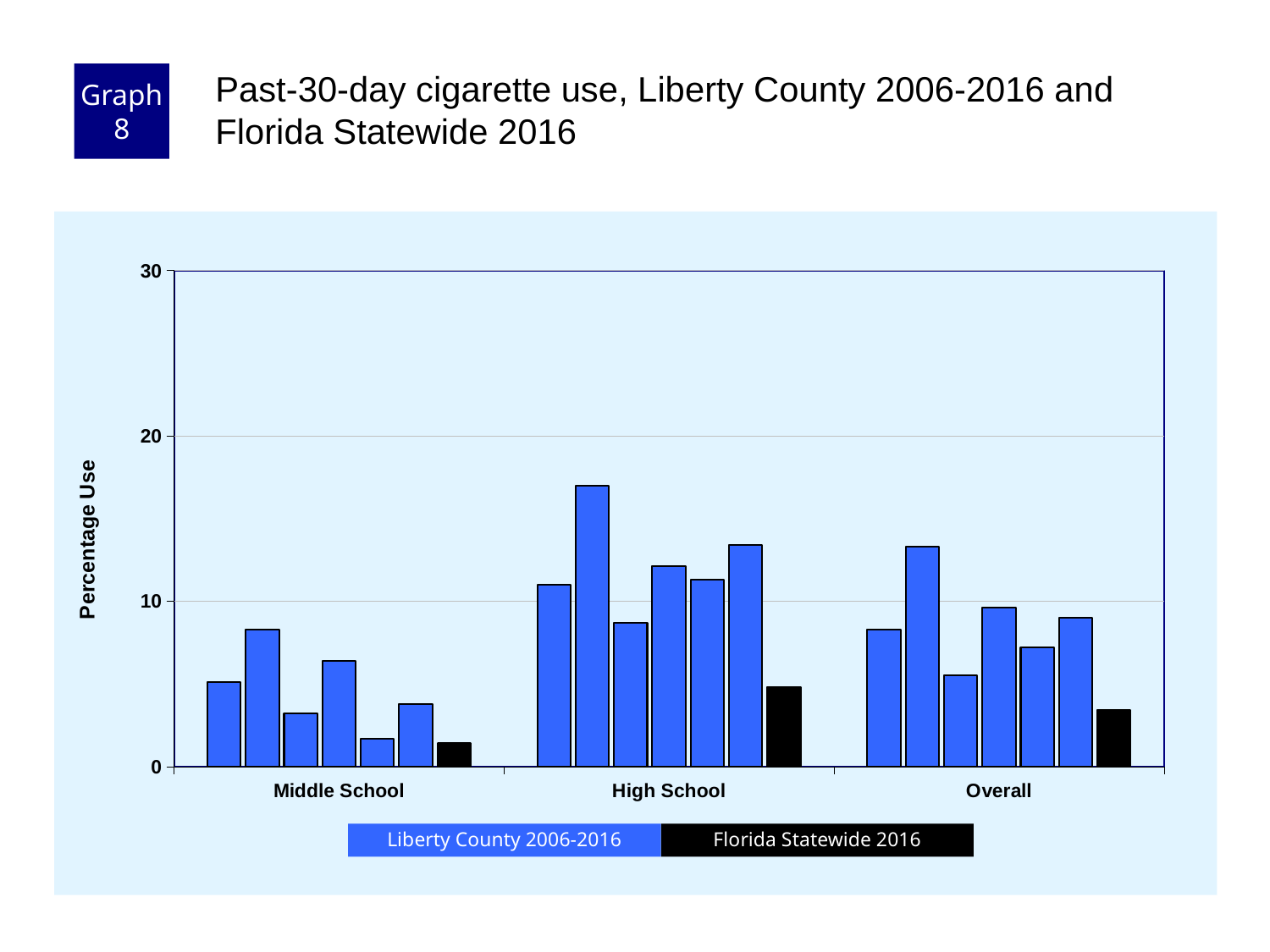
What is the label on the y axis? Percentage Use Is the Florida Statewide 2016 value for High School greater or less than 10? less Is the tallest Liberty County bar for High School greater or less than 10? greater Which is larger, the Florida Statewide 2016 value for High School or for Middle School? High School What kind of chart is shown on the slide? bar chart How many categories are shown on the x axis? 3 How many series does the legend list? 2 Which category contains the tallest bar on the chart? High School Is the Florida Statewide 2016 value for Middle School greater or less than 10? less Which category has the lowest Florida Statewide 2016 value? Middle School Which colour represents Florida Statewide 2016 in the legend? black